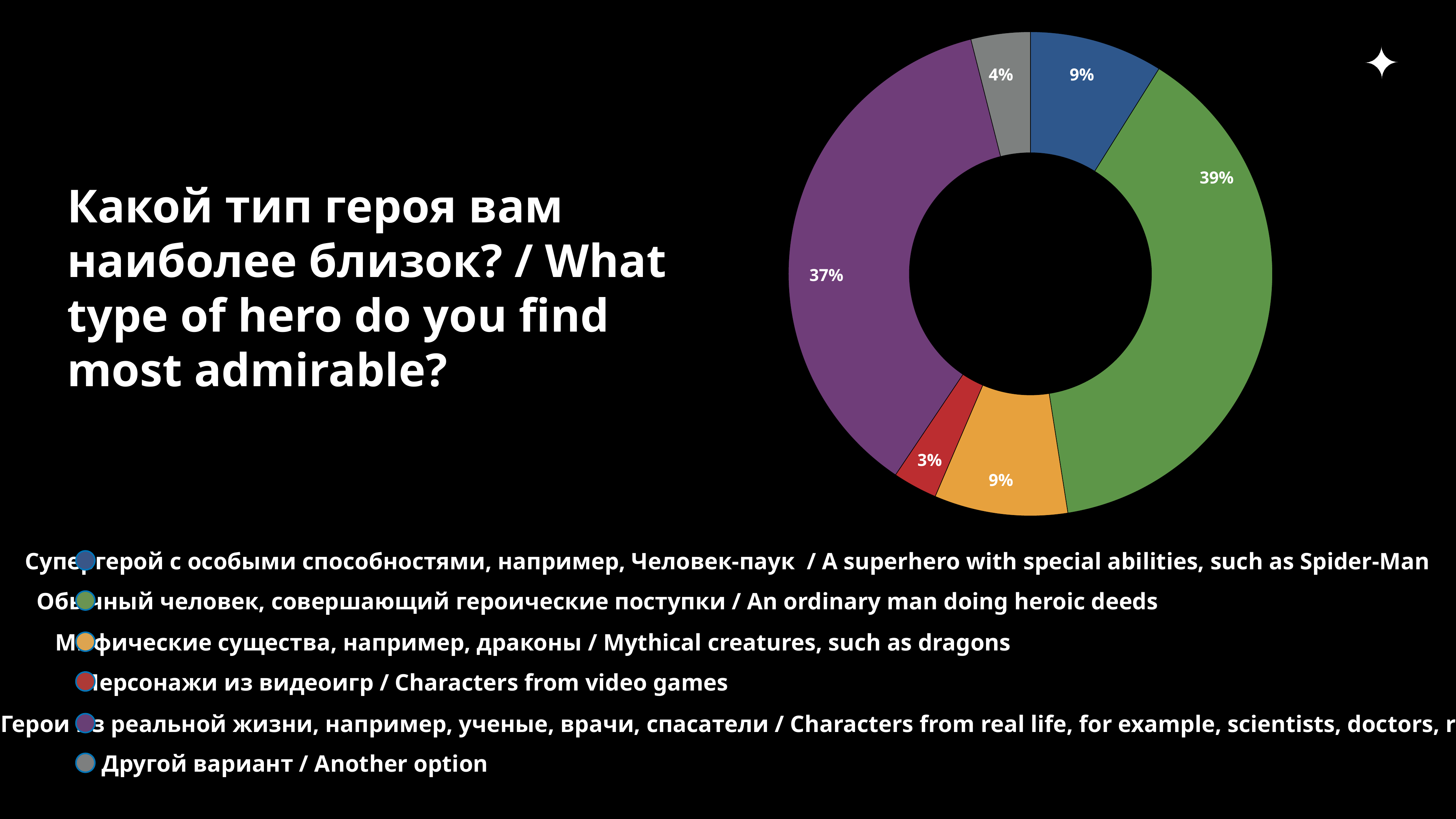
What share of the doughnut chart is for 'Characters from video games'? 3% What share of the doughnut chart is for 'Mythical creatures, such as dragons'? 9% What share of the doughnut chart is for 'Characters from real life, for example, scientists, doctors'? 37% What share of the doughnut chart is for 'An ordinary man doing heroic deeds'? 39% How many slices does the doughnut chart have? 6 What share of the doughnut chart is for 'Another option'? 4% Which is larger: the share for 'A superhero with special abilities' or the share for 'Another option'? A superhero with special abilities What kind of chart is shown on the slide? Doughnut chart Which category has the largest share in the doughnut chart? An ordinary man doing heroic deeds What colour is the slice for 'Characters from real life, for example, scientists, doctors'? Purple What is the difference in percentage points between 'An ordinary man doing heroic deeds' and 'Characters from real life'? 2 Which category has the smallest share in the doughnut chart? Characters from video games